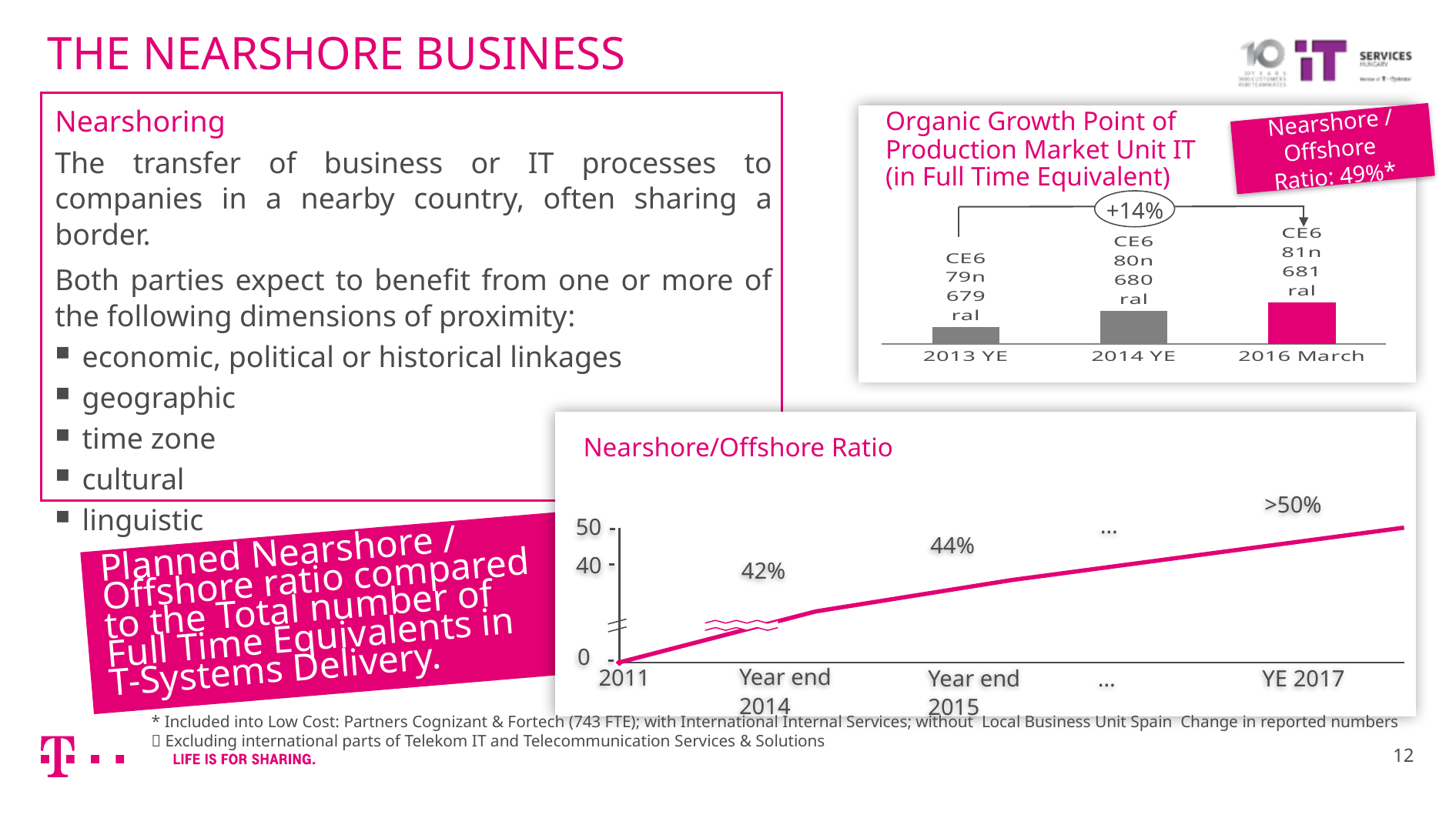
In the Nearshore/Offshore Ratio chart, what value is shown for YE 2017? >50% In the Nearshore/Offshore Ratio chart, what is the value at Year end 2014? 42% How many bars are in the Organic Growth Point of Production Market Unit IT chart? 3 What kind of chart is the Organic Growth Point of Production Market Unit IT chart? bar chart In the Organic Growth Point of Production Market Unit IT chart, which category has the tallest bar? 2016 March In the Nearshore/Offshore Ratio chart, what is the difference between the Year end 2015 and Year end 2014 values? 2% In the Nearshore/Offshore Ratio chart, is the value for 2011 greater or less than 40? less In the Nearshore/Offshore Ratio chart, does the line rise or fall from 2011 to YE 2017? rises What kind of chart is the Nearshore/Offshore Ratio chart? line chart In the Nearshore/Offshore Ratio chart, what is the value at Year end 2015? 44% In the Organic Growth Point of Production Market Unit IT chart, what growth percentage is shown in the annotation between 2013 YE and 2016 March? +14% In the Nearshore/Offshore Ratio chart, which is larger, the value at Year end 2014 or at Year end 2015? Year end 2015